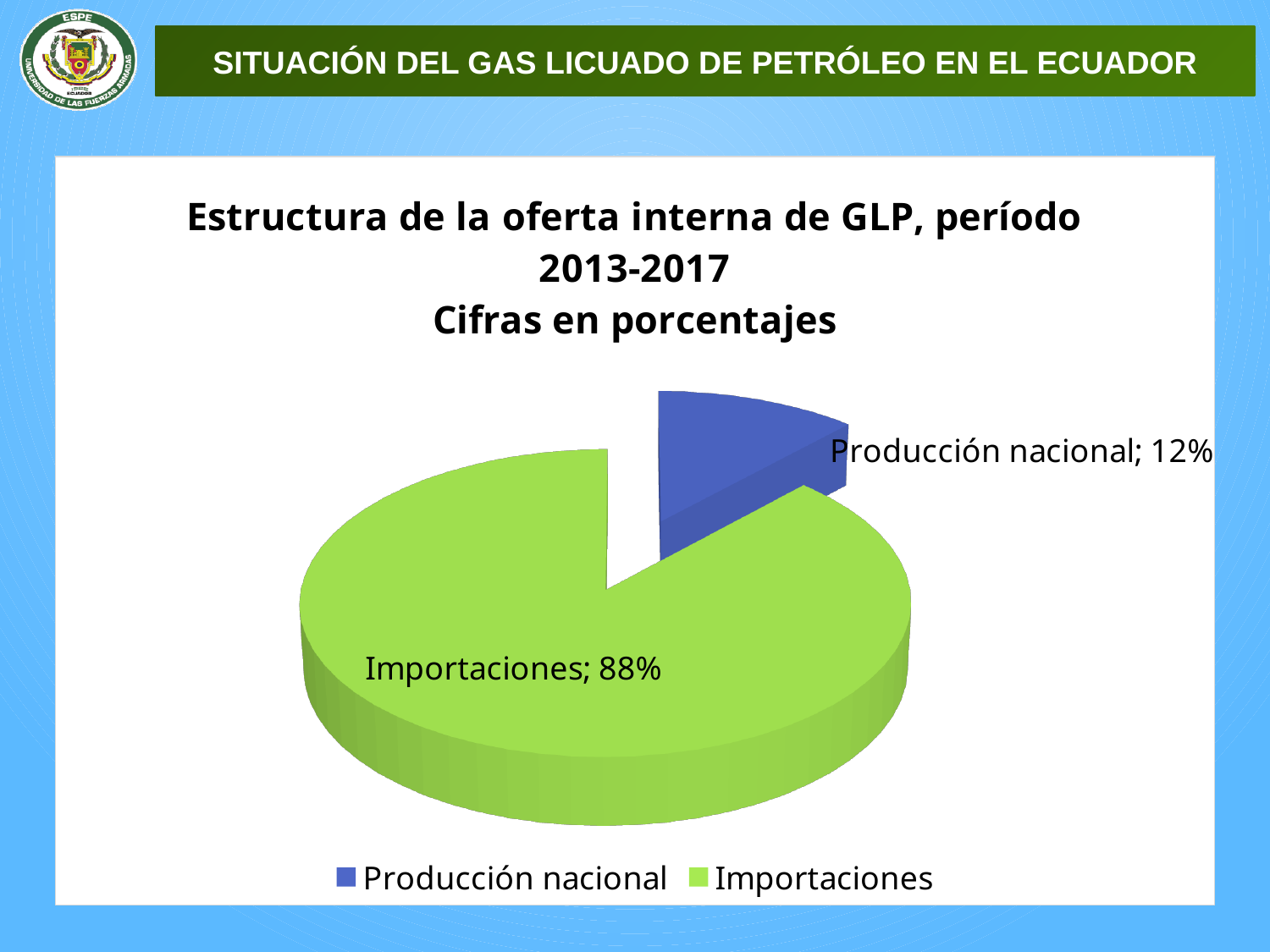
What kind of chart is shown on the slide? Pie chart What is the share of the pie taken by Importaciones? 88% Which category has the largest share of the pie? Importaciones Which category has the smallest share of the pie? Producción nacional What is the title of the chart? Estructura de la oferta interna de GLP, período 2013-2017 Cifras en porcentajes Which is larger, Producción nacional or Importaciones? Importaciones What is the total of the two slices shown? 100% What percentage of the pie is Producción nacional? 12% What colour is the Importaciones slice? Green How many slices does the pie chart have? 2 What is the difference in percentage points between Importaciones and Producción nacional? 76 What percentage of the pie is Importaciones? 88%